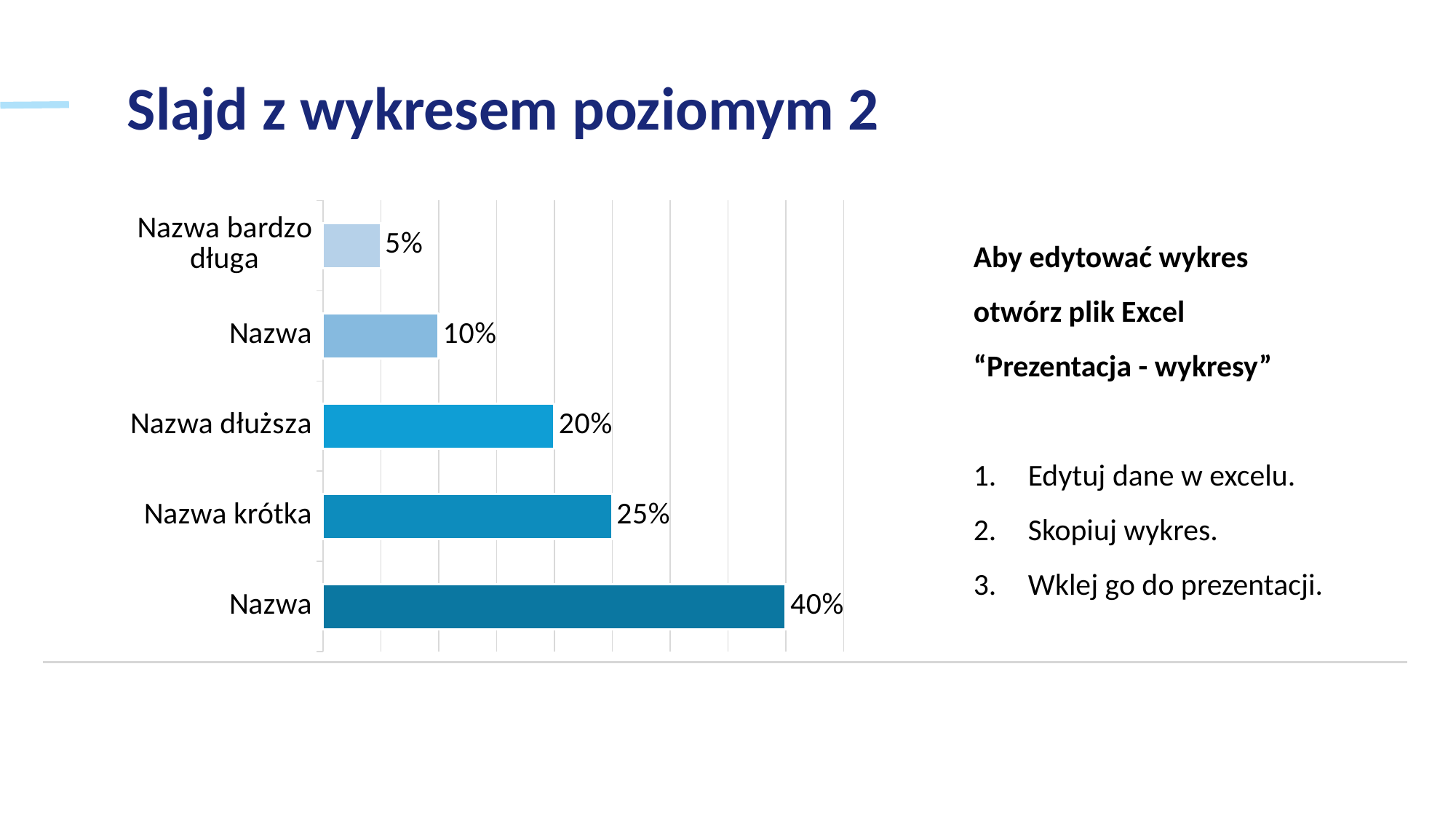
What is the value for Nazwa bardzo długa? 5% What is the value of the bottom bar, labelled Nazwa? 40% Which is larger, the value for Nazwa dłuższa or the value for Nazwa krótka? Nazwa krótka How many bars are shown in the chart? 5 Which category has the lowest value? Nazwa bardzo długa What is the value of the second bar from the top, labelled Nazwa? 10% What is the difference between the values for Nazwa krótka and Nazwa dłuższa? 5% What is the difference between the bottom bar (Nazwa, 40%) and Nazwa bardzo długa? 35% What is the value for Nazwa krótka? 25% What is the value for Nazwa dłuższa? 20% What kind of chart is shown on the slide? bar chart Which category has the highest value? Nazwa (the bottom bar)